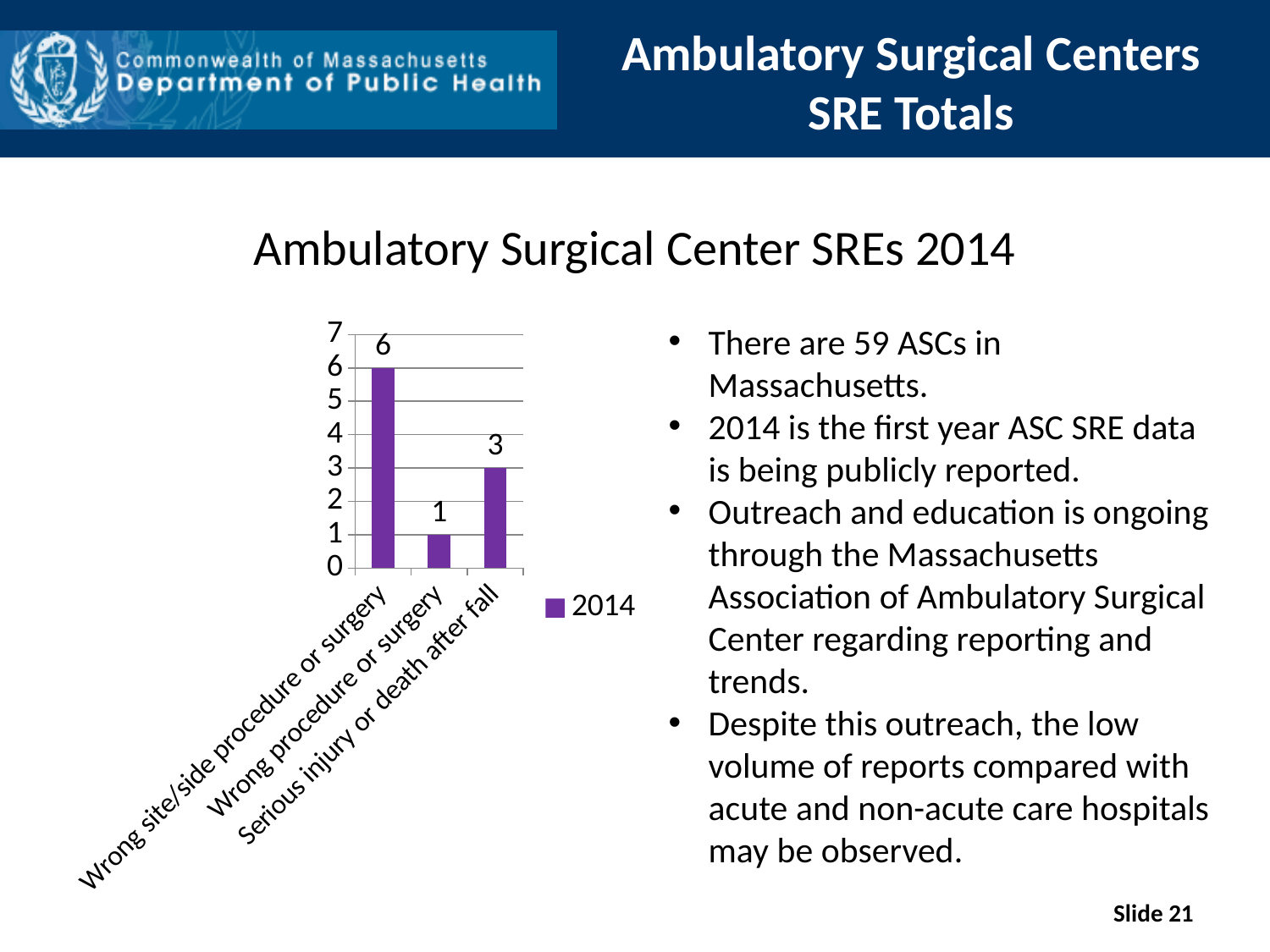
Which category has the highest value? Wrong site/side procedure or surgery Which category has the lowest value? Wrong procedure or surgery What is the value for Wrong procedure or surgery? 1 Which is larger, the value for Serious injury or death after fall or the value for Wrong procedure or surgery? Serious injury or death after fall What is the value for Serious injury or death after fall? 3 What is the value for Wrong site/side procedure or surgery? 6 What is the difference between the values for Wrong site/side procedure or surgery and Serious injury or death after fall? 3 What kind of chart is shown? bar chart Is the value for Wrong site/side procedure or surgery greater or less than 5? greater How many series does the legend list? 1 What is the title of the chart? Ambulatory Surgical Center SREs 2014 How many categories are shown on the x axis? 3